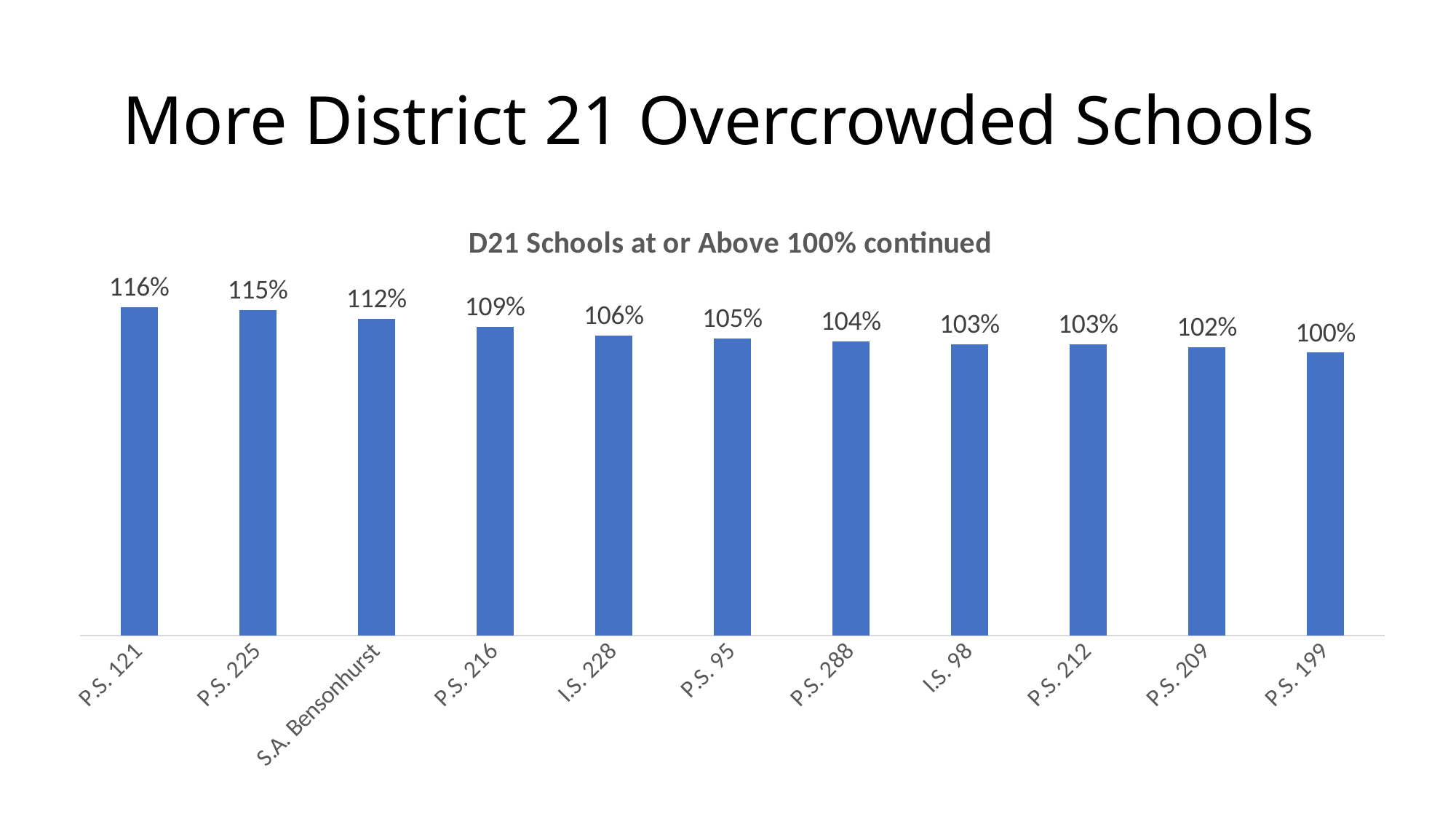
What is the value for P.S. 121? 116% What kind of chart is shown on the slide? Bar chart How many schools are shown in the chart? 11 Which is larger, the value for P.S. 95 or the value for P.S. 209? P.S. 95 What is the value for P.S. 199? 100% What is the difference between the values for P.S. 225 and P.S. 216? 6% Which school has the highest value? P.S. 121 Which school has the lowest value? P.S. 199 What is the title of the chart? D21 Schools at or Above 100% continued What is the difference between the values for P.S. 121 and P.S. 199? 16% What is the value for I.S. 228? 106% What is the value for S.A. Bensonhurst? 112%